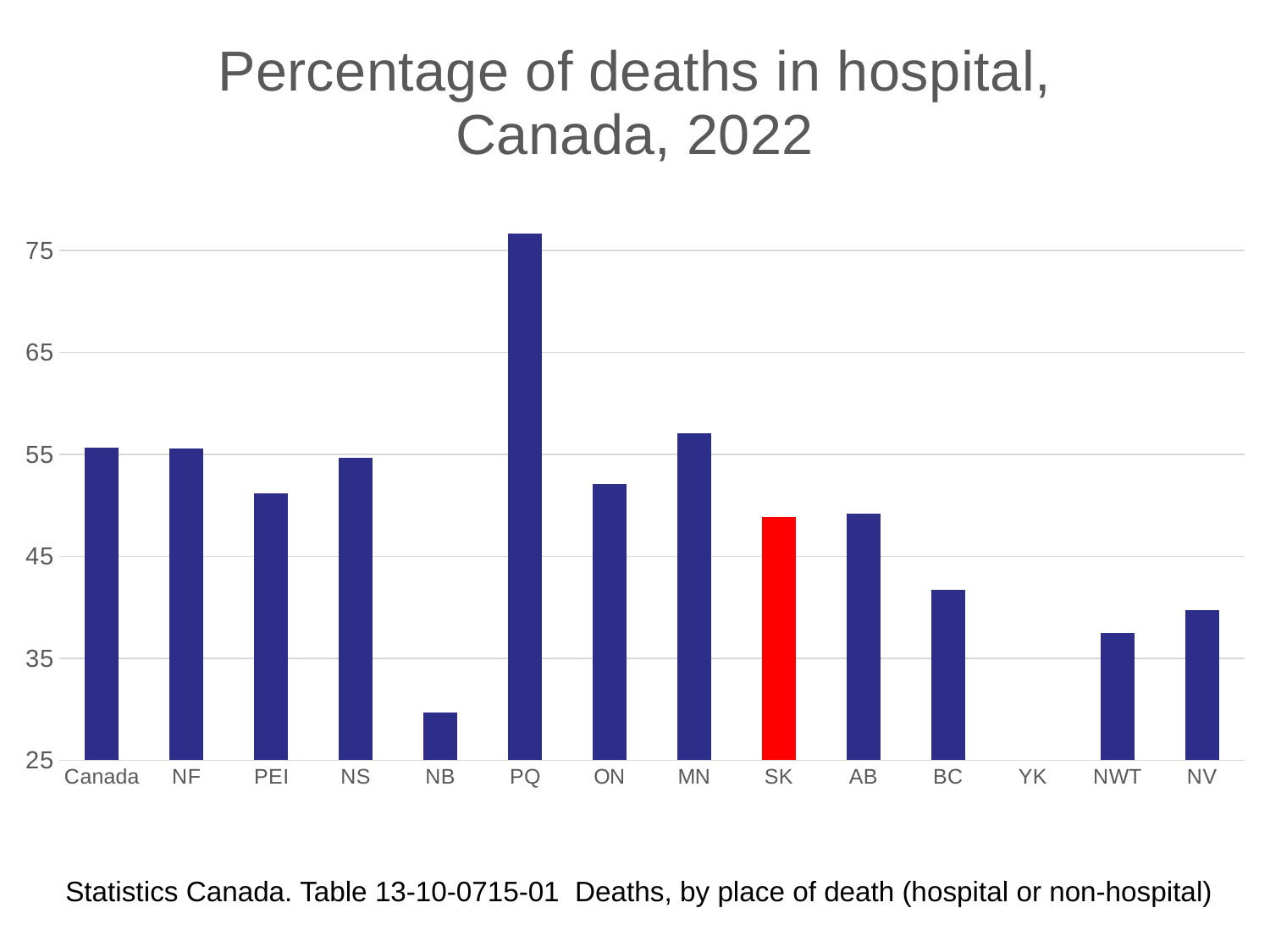
How many categories are listed along the x axis? 14 Is the value for NB greater or less than 35? less Which category's bar is coloured red? SK Which has the larger value, NB or NWT? NWT Is the value for PQ greater or less than 75? greater What kind of chart is shown on the slide? bar chart Is the value for MN greater or less than 55? greater Which has the larger value, MN or ON? MN Which category has the tallest bar? PQ Which category has the shortest visible bar? NB